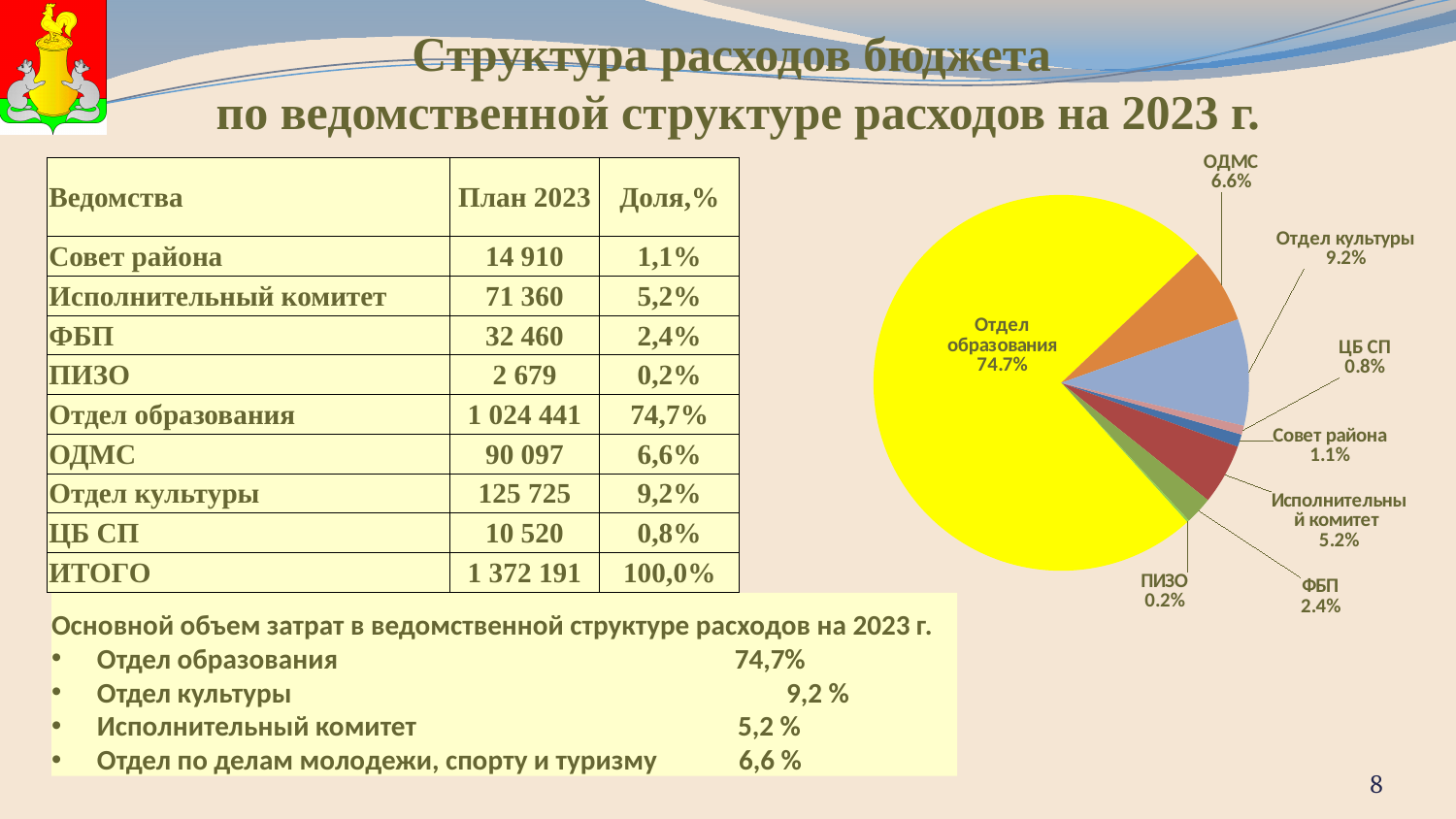
How many slices does the pie chart have? 8 What share of the pie chart does Отдел культуры have? 9.2% In the pie chart, what is the difference in percentage points between Отдел культуры and ОДМС? 2.6 What share of the pie chart does ПИЗО have? 0.2% In the pie chart, which is larger: Отдел культуры or Исполнительный комитет? Отдел культуры What share of the pie chart does ОДМС have? 6.6% Which slice of the pie chart is the smallest? ПИЗО Which slice of the pie chart is the largest? Отдел образования In the pie chart, what is the difference in percentage points between Исполнительный комитет and ФБП? 2.8 What colour is the Отдел образования slice in the pie chart? yellow What kind of chart is shown on the slide? pie chart